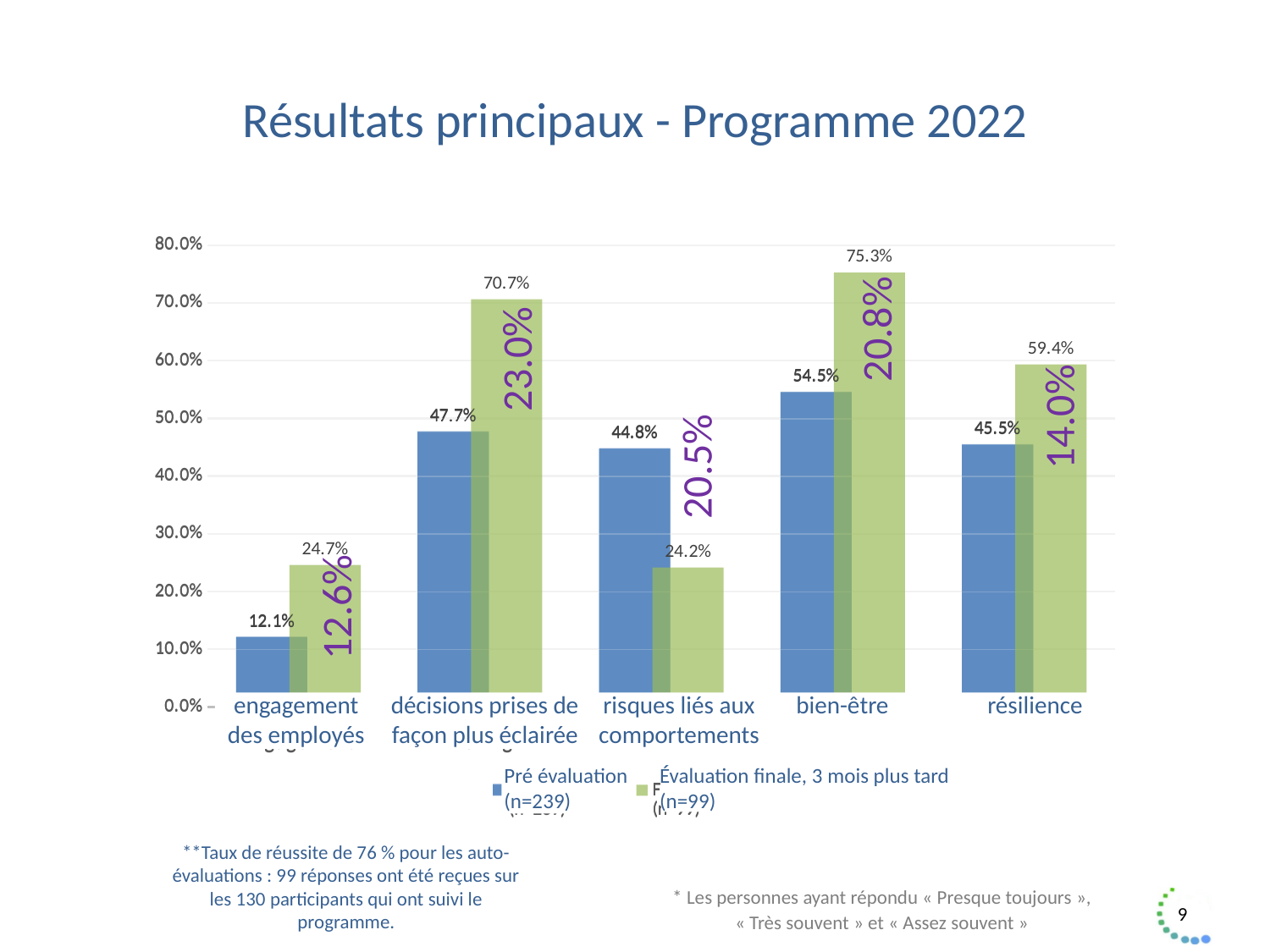
Is the Évaluation finale, 3 mois plus tard (n=99) value for résilience greater or less than 50.0%? greater What is the Pré évaluation (n=239) value for risques liés aux comportements? 44.8% How many categories are shown on the x axis? 5 Which category has the highest Évaluation finale, 3 mois plus tard (n=99) value? bien-être What is the difference between the Évaluation finale and Pré évaluation values for décisions prises de façon plus éclairée? 23.0% What is the Évaluation finale, 3 mois plus tard (n=99) value for bien-être? 75.3% Which category has the lowest Pré évaluation (n=239) value? engagement des employés How many series does the legend list? 2 For risques liés aux comportements, which is larger: the Pré évaluation value or the Évaluation finale value? Pré évaluation (n=239) What type of chart is shown on the slide? bar chart What is the Pré évaluation (n=239) value for engagement des employés? 12.1% What is the title of the chart slide? Résultats principaux - Programme 2022